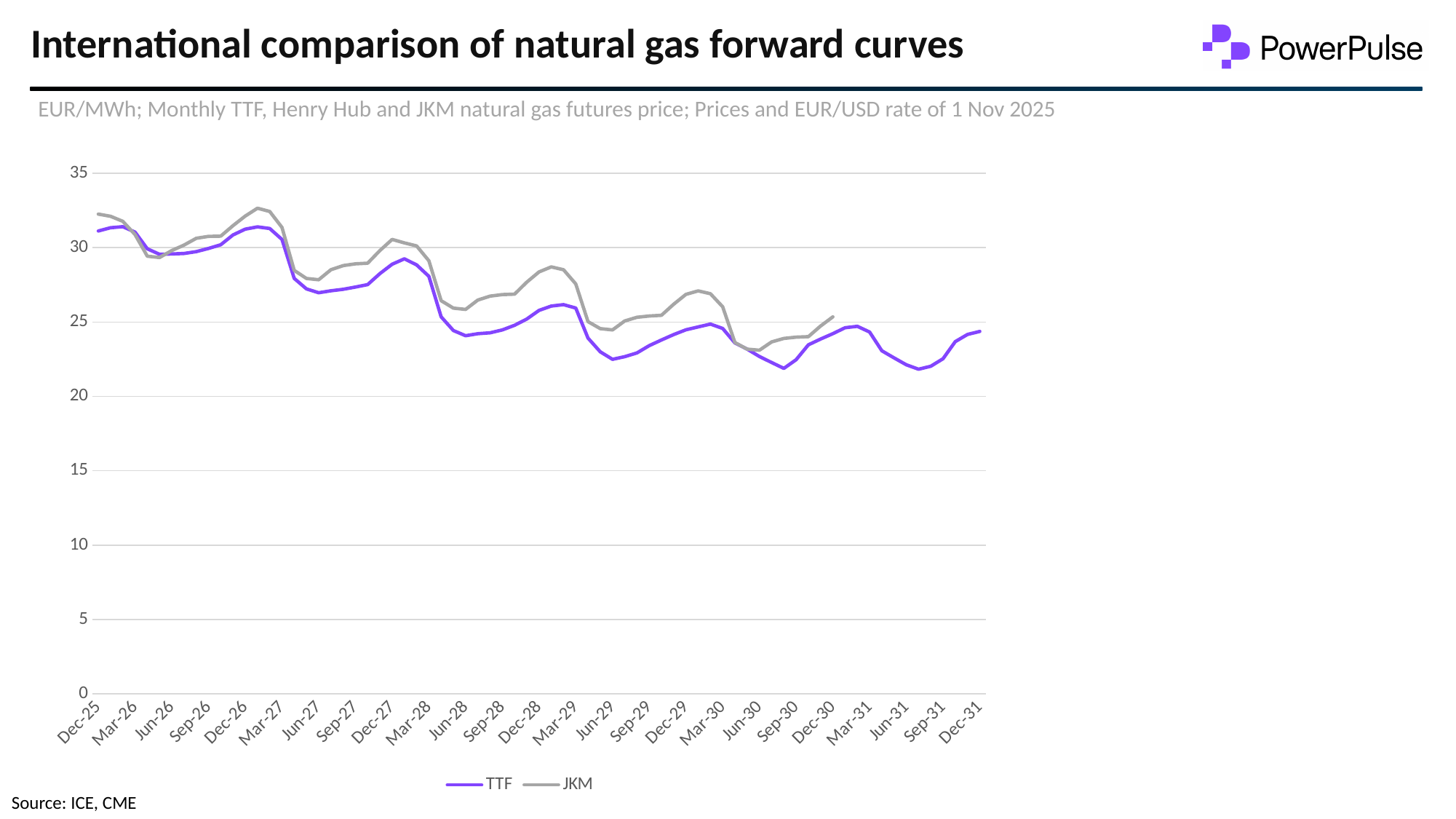
What colour is the TTF line? purple At Dec-25, which series has the higher value, TTF or JKM? JKM What are the two series named in the legend? TTF and JKM At Dec-28, which series has the higher value, TTF or JKM? JKM Is the TTF value at Jun-31 greater or less than 25? less Is the TTF value at Jun-28 greater or less than 25? less How many series does the legend list? 2 Does the TTF line generally rise or fall from Dec-25 to Dec-31? fall What kind of chart is shown on the slide? line chart Is the JKM value at Mar-27 greater or less than 30? greater How many date labels are shown on the x axis? 25